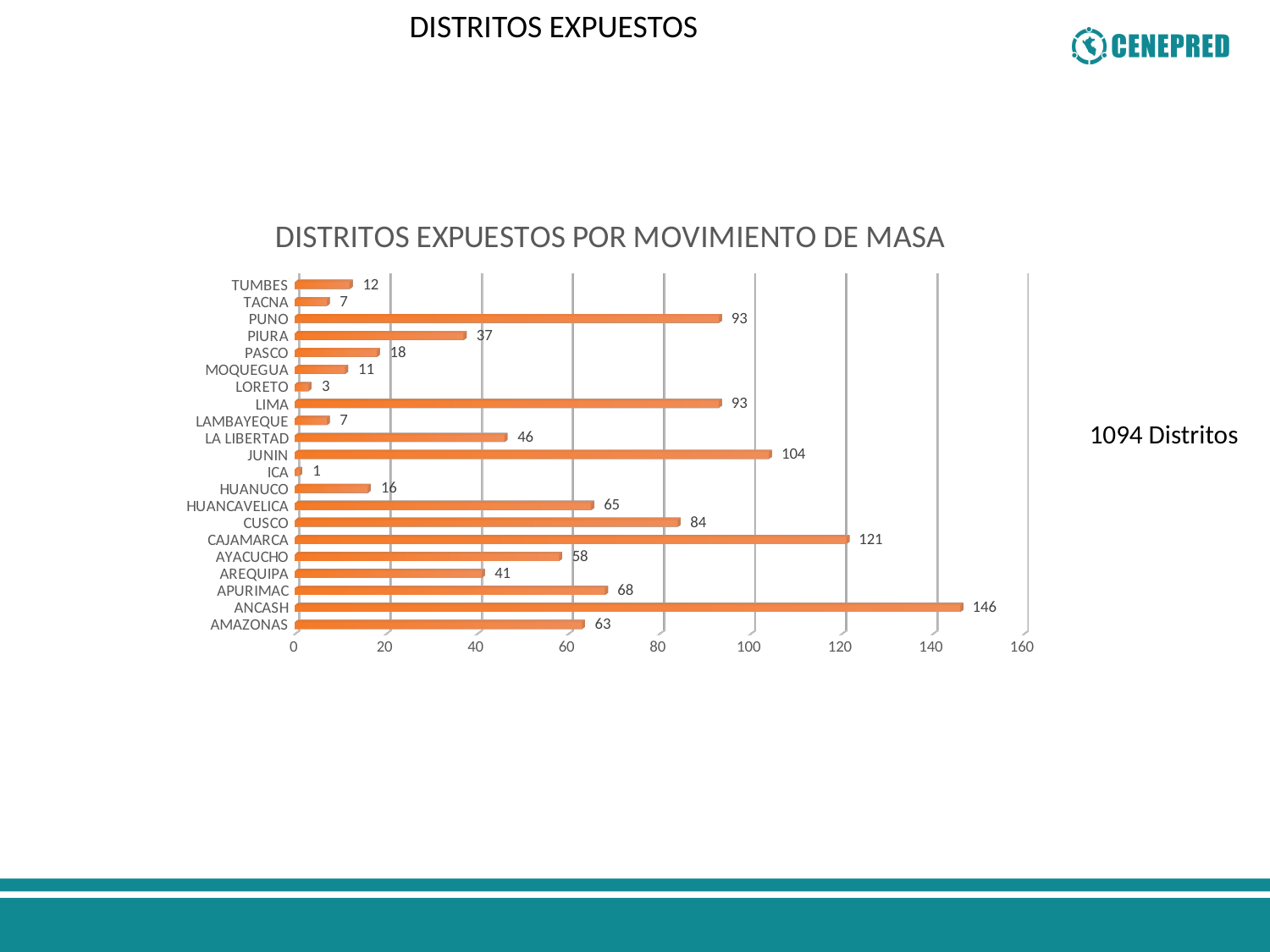
Which region has the highest value? ANCASH What is the value for LA LIBERTAD? 46 How many regions are shown on the chart? 21 What is the value for CAJAMARCA? 121 Which region has the lowest value? ICA What is the title of the chart? DISTRITOS EXPUESTOS POR MOVIMIENTO DE MASA What kind of chart is shown? Bar chart What is the value for ANCASH? 146 Which is larger, the value for CUSCO or the value for HUANCAVELICA? CUSCO What is the difference between the values for JUNIN and PUNO? 11 What is the difference between the values for ANCASH and CAJAMARCA? 25 Is the value for JUNIN greater or less than 100? greater